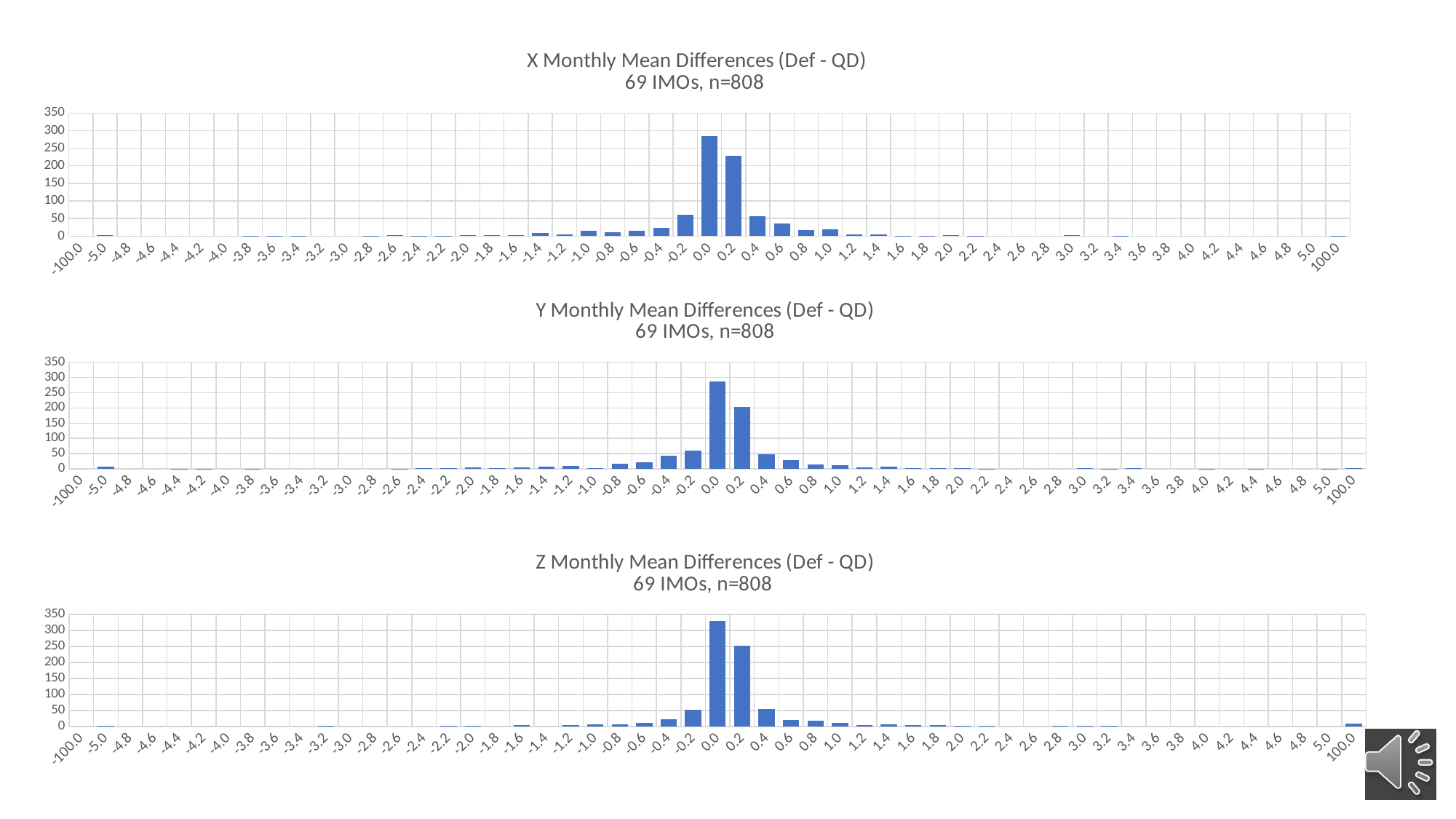
In the X Monthly Mean Differences chart, is the value for 0.0 greater or less than 250? greater How many charts are shown on the slide? 3 In the Y Monthly Mean Differences chart, is the value for 0.2 greater or less than 150? greater In the X Monthly Mean Differences chart, which category has the highest bar? 0.0 What kind of chart is the X Monthly Mean Differences chart? bar chart In the Z Monthly Mean Differences chart, which is larger, the value for 0.2 or the value for 0.4? 0.2 In the X Monthly Mean Differences chart, which is larger, the value for 0.0 or the value for 0.2? 0.0 In the Y Monthly Mean Differences chart, which is larger, the value for -0.2 or the value for -0.6? -0.2 In the Z Monthly Mean Differences chart, is the value for 0.2 greater or less than 200? greater In the Y Monthly Mean Differences chart, which category has the highest bar? 0.0 What is the title of the bottom chart on the slide? Z Monthly Mean Differences (Def - QD) 69 IMOs, n=808